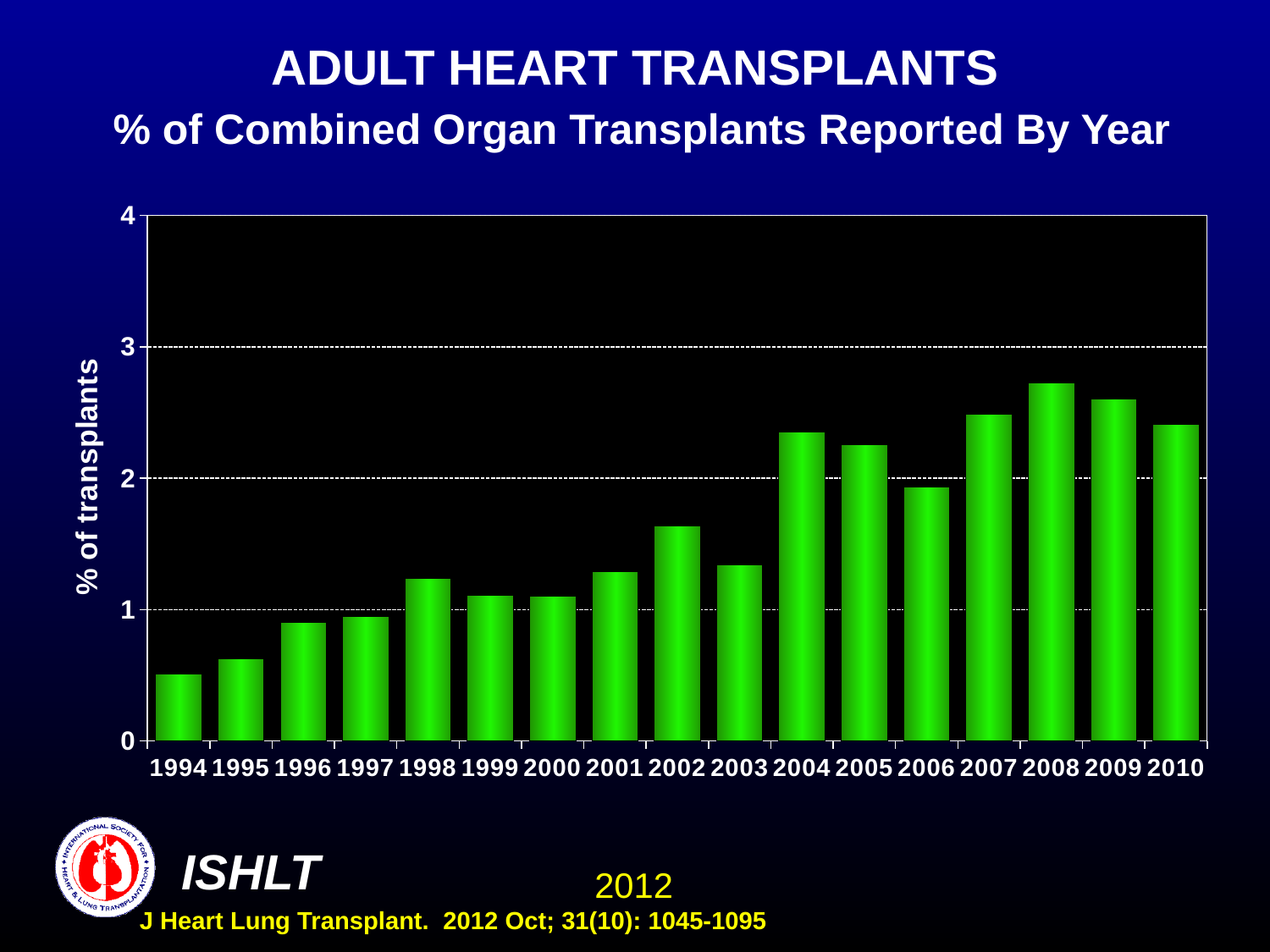
Which year has the highest % of transplants? 2008 Overall, do the values rise or fall from 1994 to 2010? rise Which year has the larger value, 2002 or 2003? 2002 Is the value for 1998 greater or less than 1? greater What is the label on the y axis of the chart? % of transplants Which year has the lowest % of transplants? 1994 How many years are shown on the x axis of the chart? 17 What kind of chart is shown on the slide? bar chart Is the value for 2004 greater or less than 2? greater Is the value for 1994 greater or less than 1? less Which year has the larger value, 2003 or 2004? 2004